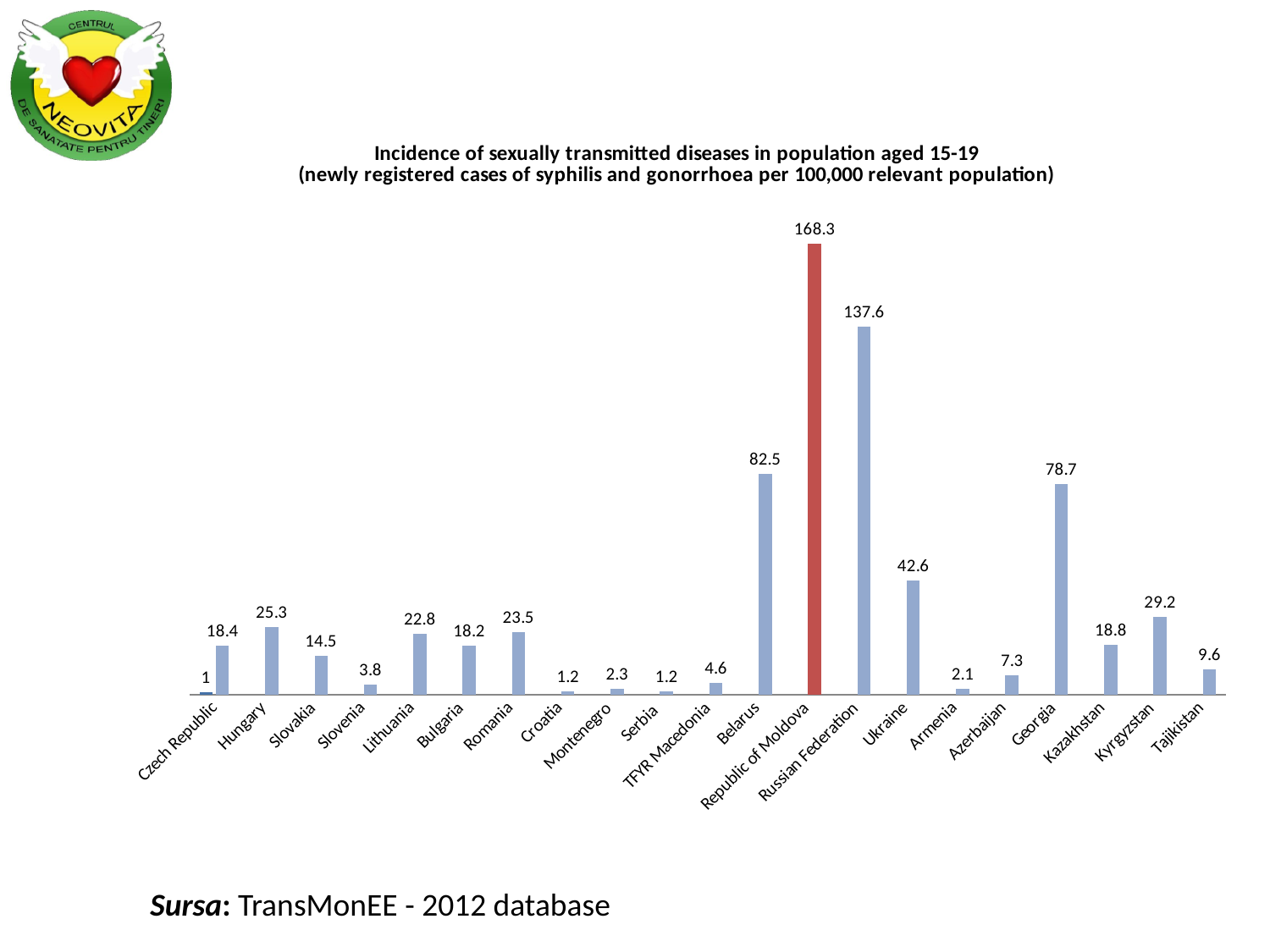
What is the value for Georgia? 78.7 What is the value for Kyrgyzstan? 29.2 What is the difference between the values for Belarus and Ukraine? 39.9 What is the value for Belarus? 82.5 Which country's bar is coloured red instead of blue? Republic of Moldova What is the value for Republic of Moldova? 168.3 Which country has the highest value? Republic of Moldova Which is larger, the value for Hungary or the value for Slovakia? Hungary What kind of chart is this? Bar chart What is the difference between the values for Republic of Moldova and Russian Federation? 30.7 How many countries are shown on the chart? 21